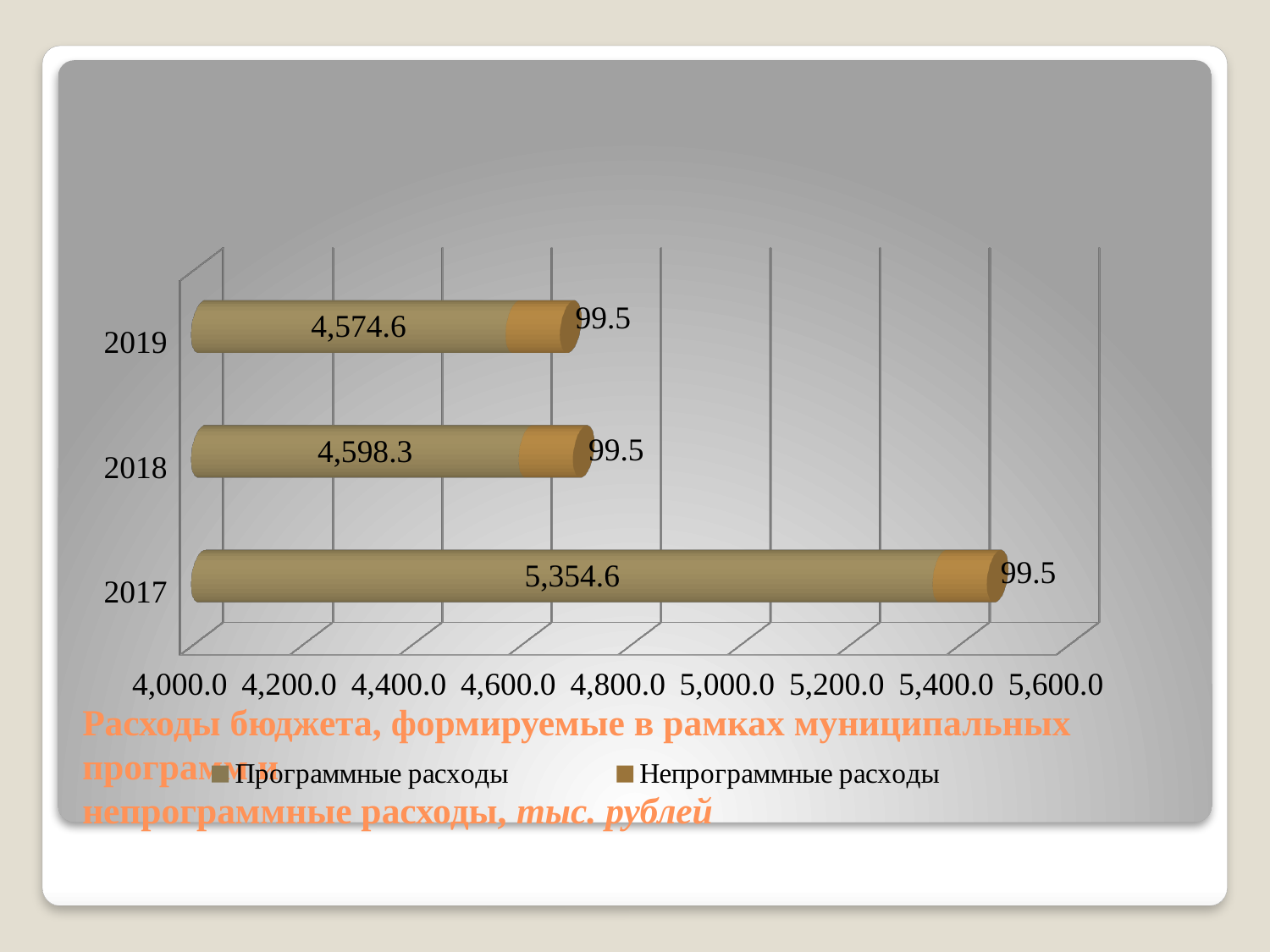
How many series does the legend list? 2 Which is larger: Программные расходы in 2018 or in 2019? 2018 How many years are shown on the chart? 3 What is the value of Программные расходы for 2017? 5,354.6 What is the total of the stacked bar for 2017? 5,454.1 Which year has the highest value of Программные расходы? 2017 Which year has the lowest value of Программные расходы? 2019 What is the difference between Программные расходы in 2018 and 2019? 23.7 What kind of chart is shown on the slide? Bar chart What is the difference between Программные расходы in 2017 and 2018? 756.3 What is the value of Непрограммные расходы for 2018? 99.5 What is the value of Программные расходы for 2019? 4,574.6